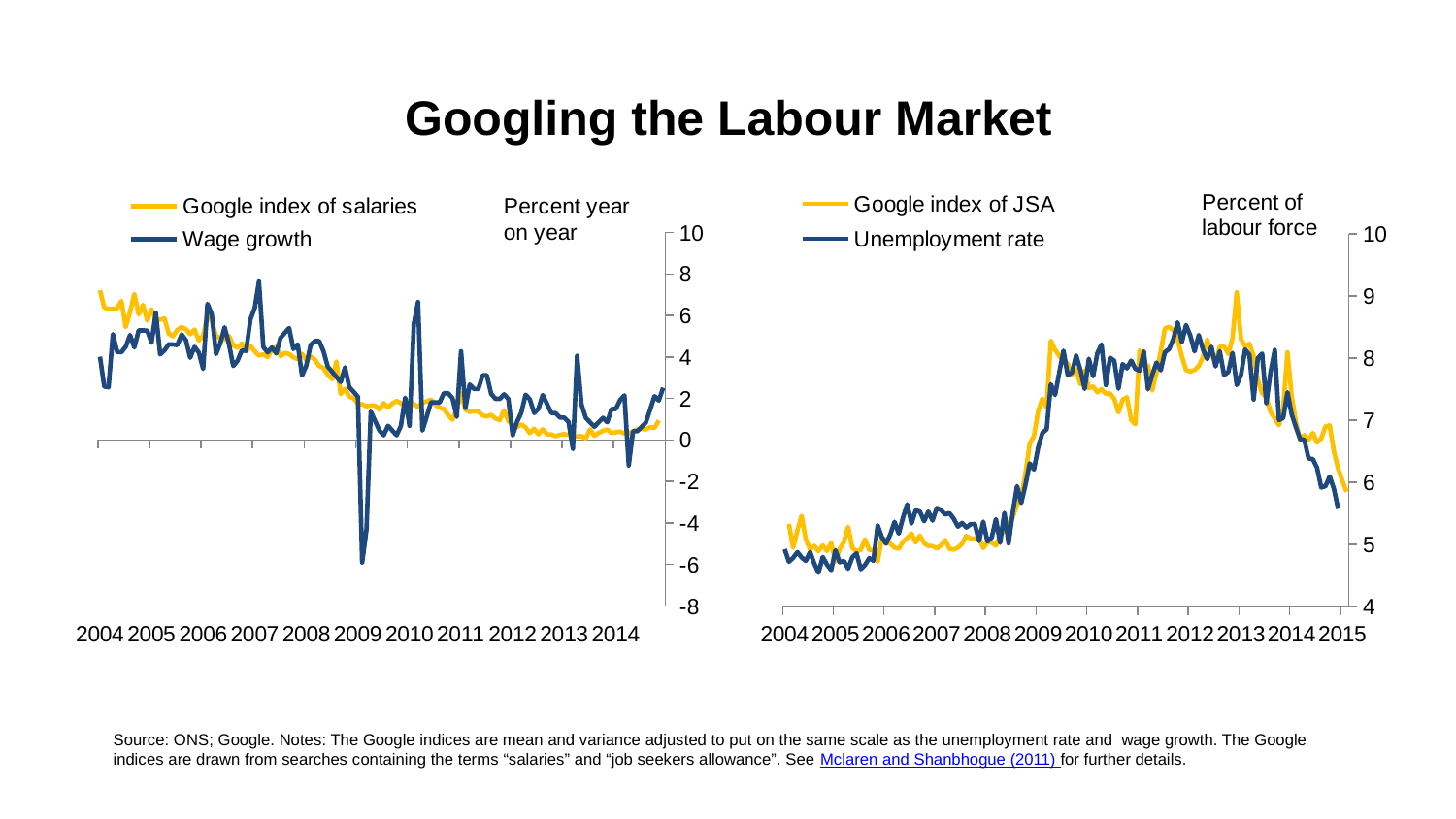
In the right chart, what is the axis label shown above the vertical axis? Percent of labour force What kind of chart is the left chart, 'Percent year on year'? Line chart In the right chart, does the Unemployment rate rise or fall between 2008 and 2009? rise In the right chart, does the Unemployment rate rise or fall between 2012 and 2015? fall In the right chart, is the Unemployment rate at the start of 2012 greater or less than 8? greater How many series does the legend of the left chart list? 2 How many year labels are shown on the x axis of the right chart? 12 In the left chart, is the lowest value of Wage growth in 2009 greater or less than -4? less How many series does the legend of the right chart list? 2 What kind of chart is the right chart, 'Percent of labour force'? Line chart In the left chart, which two series are shown in the legend? Google index of salaries and Wage growth